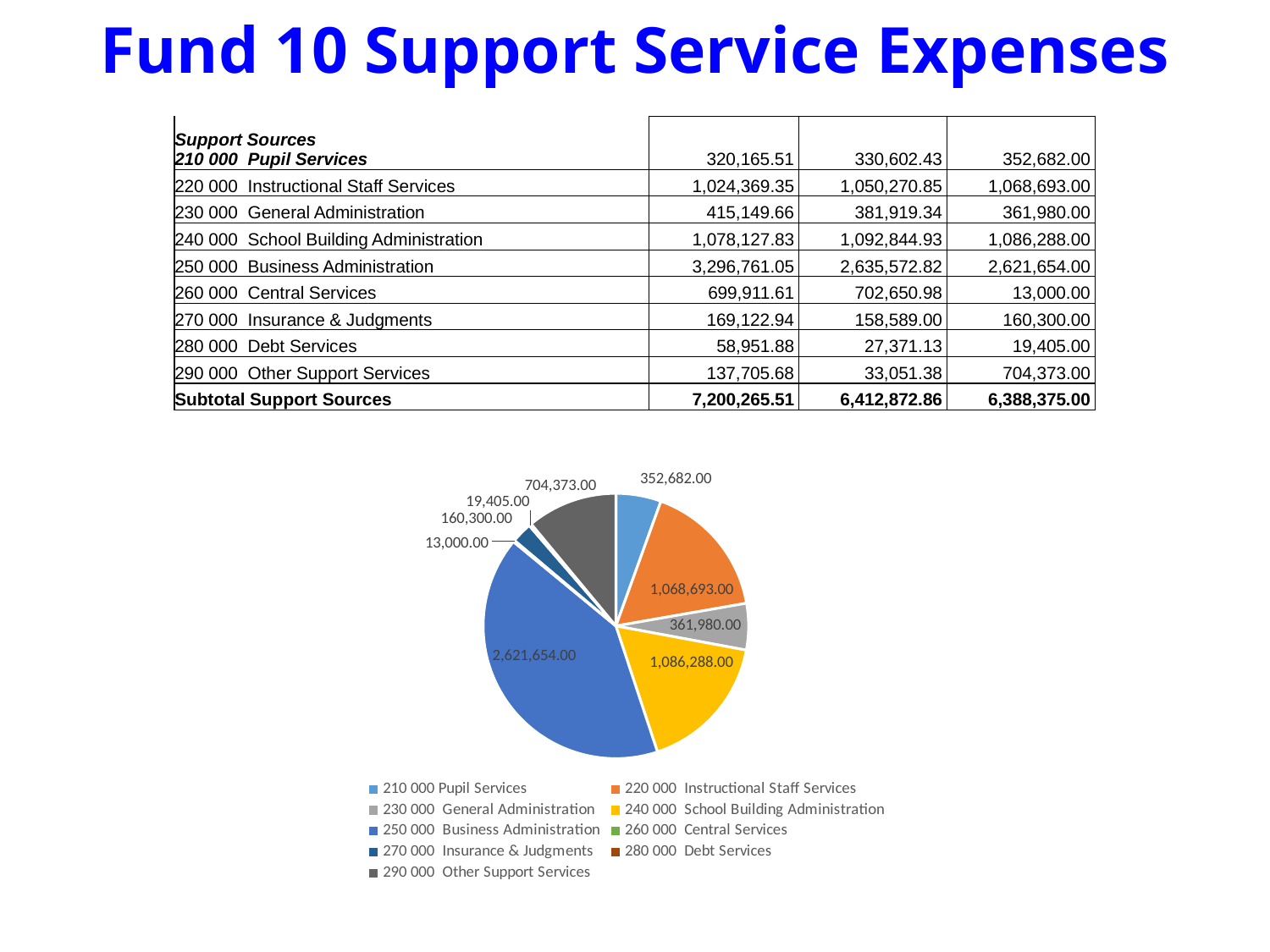
In the pie chart, what is the value for 260 000 Central Services? 13,000.00 In the pie chart, what is the difference between the values for 250 000 Business Administration and 240 000 School Building Administration? 1,535,366.00 What type of chart is shown on the slide? pie chart In the pie chart, what is the value for 250 000 Business Administration? 2,621,654.00 In the pie chart, which is larger: 290 000 Other Support Services or 230 000 General Administration? 290 000 Other Support Services What is the title of the slide containing the pie chart? Fund 10 Support Service Expenses How many slices does the pie chart have? 9 Which category has the smallest slice in the pie chart? 260 000 Central Services In the pie chart, what is the value for 290 000 Other Support Services? 704,373.00 Which category has the largest slice in the pie chart? 250 000 Business Administration How many entries does the pie chart's legend list? 9 In the pie chart, what is the value for 240 000 School Building Administration? 1,086,288.00